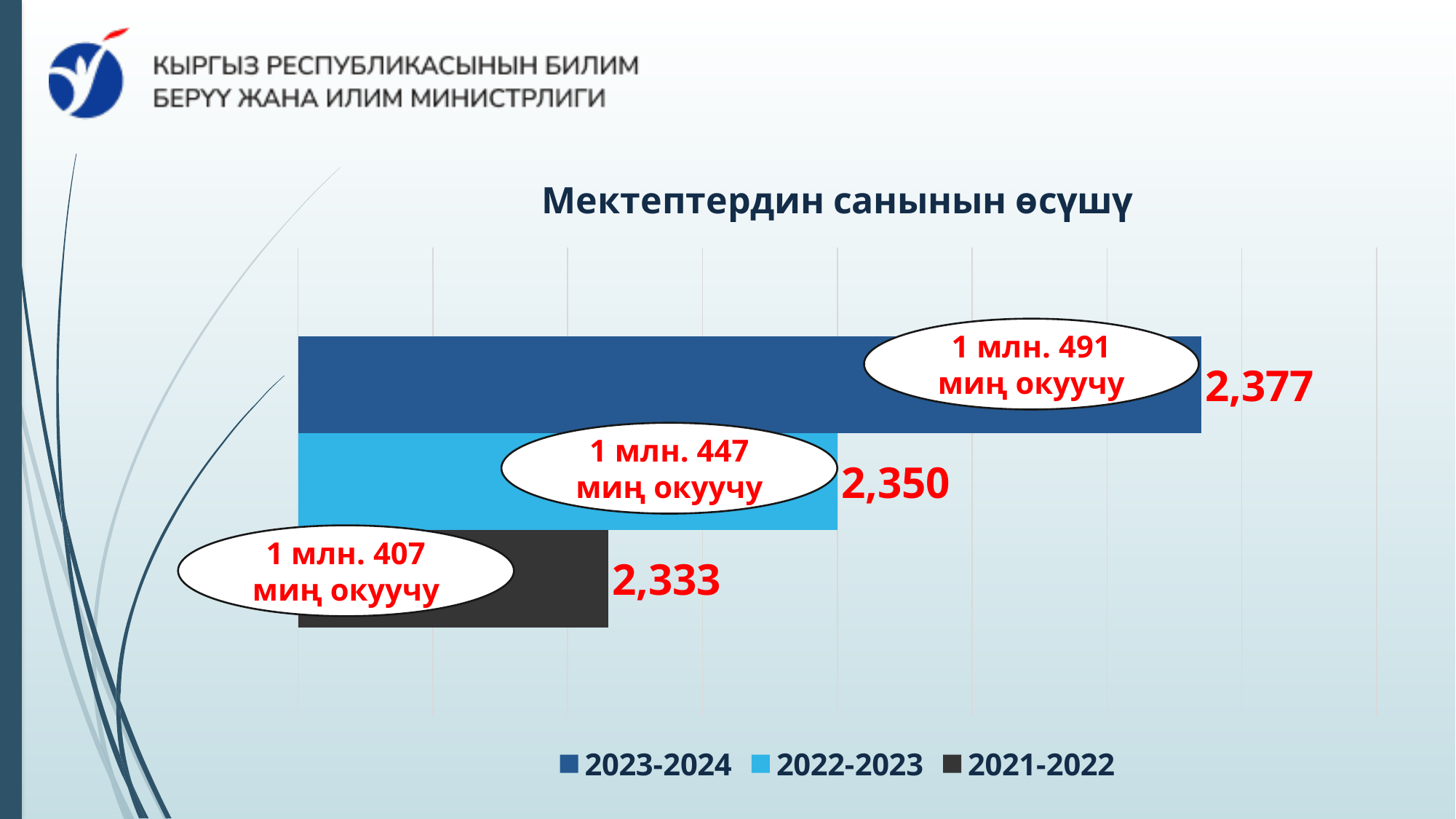
What is the difference between the values for 2022-2023 and 2021-2022? 17 What is the title of the chart? Мектептердин санынын өсүшү Which school year has the lowest value? 2021-2022 What is the difference between the values for 2023-2024 and 2022-2023? 27 What is the value for 2021-2022? 2,333 Which school year has the highest value? 2023-2024 What is the value for 2023-2024? 2,377 Which is larger, the value for 2022-2023 or the value for 2021-2022? 2022-2023 How many series does the legend list? 3 What kind of chart is shown on the slide? Bar chart What is the value for 2022-2023? 2,350 What is the difference between the values for 2023-2024 and 2021-2022? 44